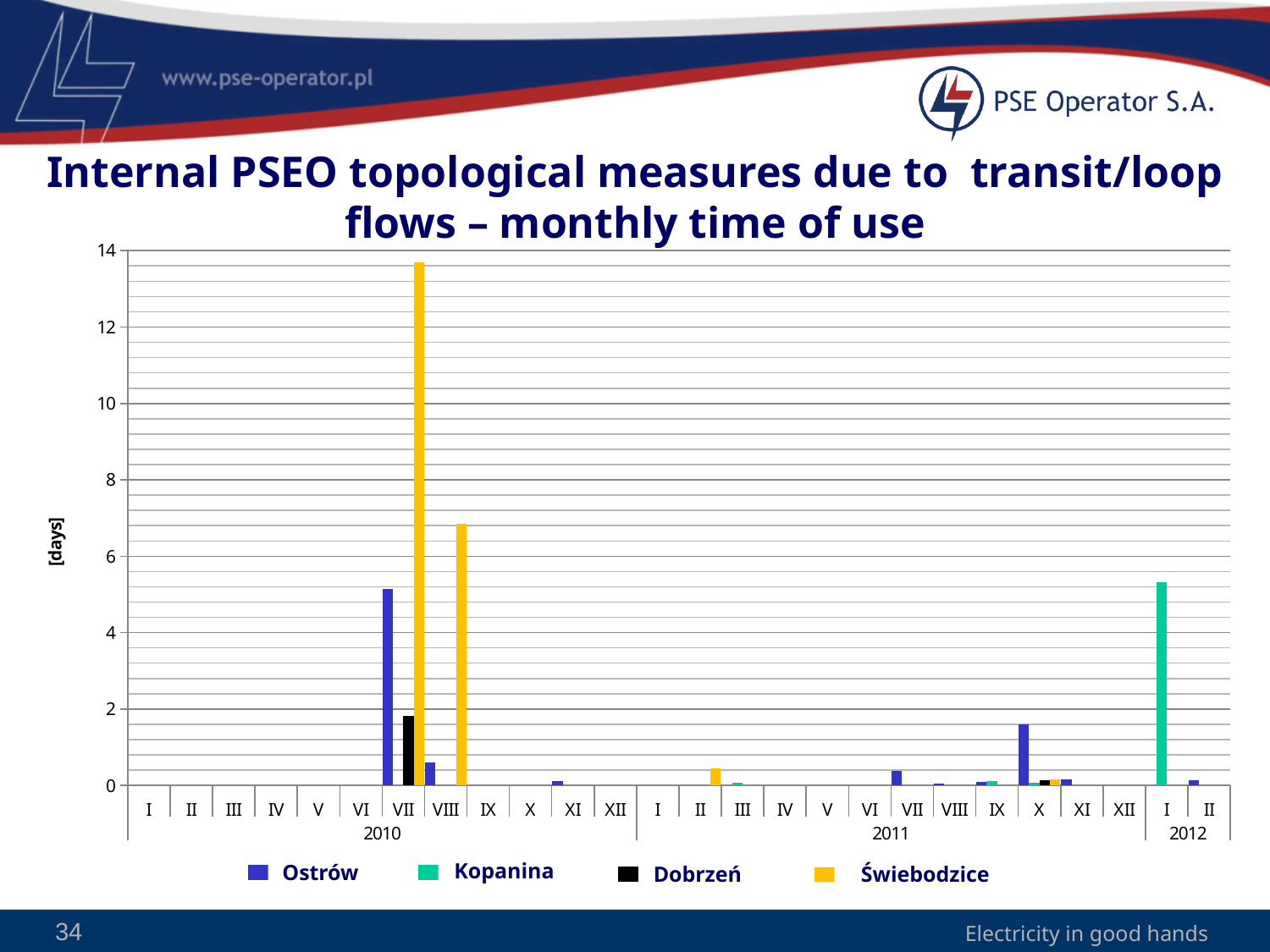
Is the value for Ostrów in month X of 2011 greater or less than 2? less Which series has the tallest bar in month VII of 2010? Świebodzice How many series does the legend list? 4 Which series has the tallest bar in month I of 2012? Kopanina Is the value for Ostrów in month VII of 2010 greater or less than 4? greater Is the value for Świebodzice in month VIII of 2010 greater or less than 6? greater What unit is shown on the vertical axis label? [days] What kind of chart is shown on the slide? bar chart Which is larger: the Świebodzice value in month VII of 2010 or in month VIII of 2010? month VII of 2010